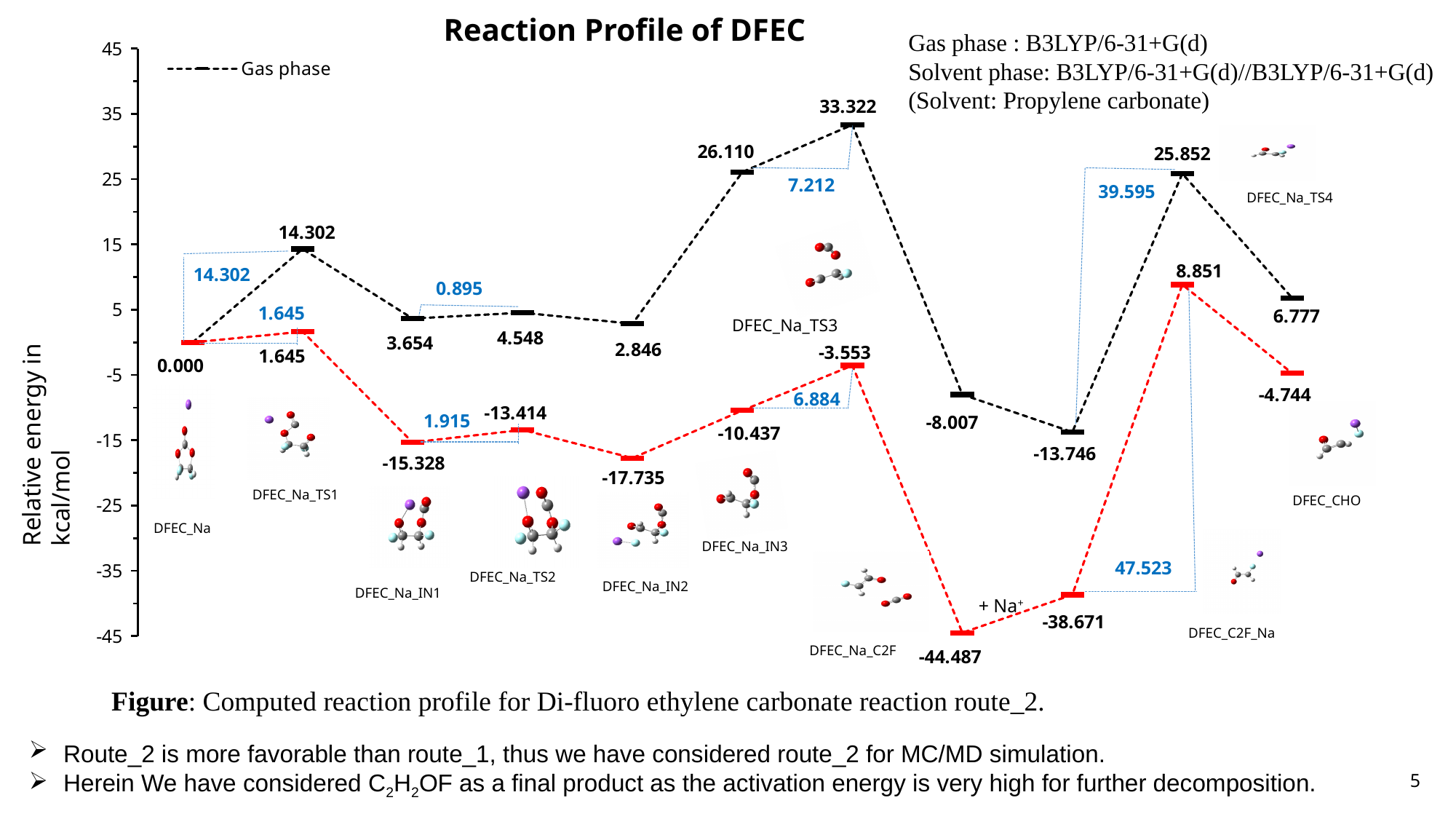
What is the difference between the Gas phase values 33.322 and 26.110? 7.212 Is the lowest point on the red dashed line greater or less than -35? less What is the highest value on the black dashed Gas phase line? 33.322 What kind of chart is shown on the slide? line chart What is the value of the first point of the profile, at the starting species DFEC_Na? 0.000 What is the label of the vertical axis? Relative energy in kcal/mol What is the title of the chart? Reaction Profile of DFEC What is the lowest value on the red dashed line? -44.487 What is the value of the last point on the red dashed line? -4.744 What is the value of the last point on the black dashed Gas phase line? 6.777 Which is larger on the Gas phase line: the peak at 33.322 or the peak at 25.852? 33.322 What is the difference between the Gas phase values 25.852 and -13.746? 39.598